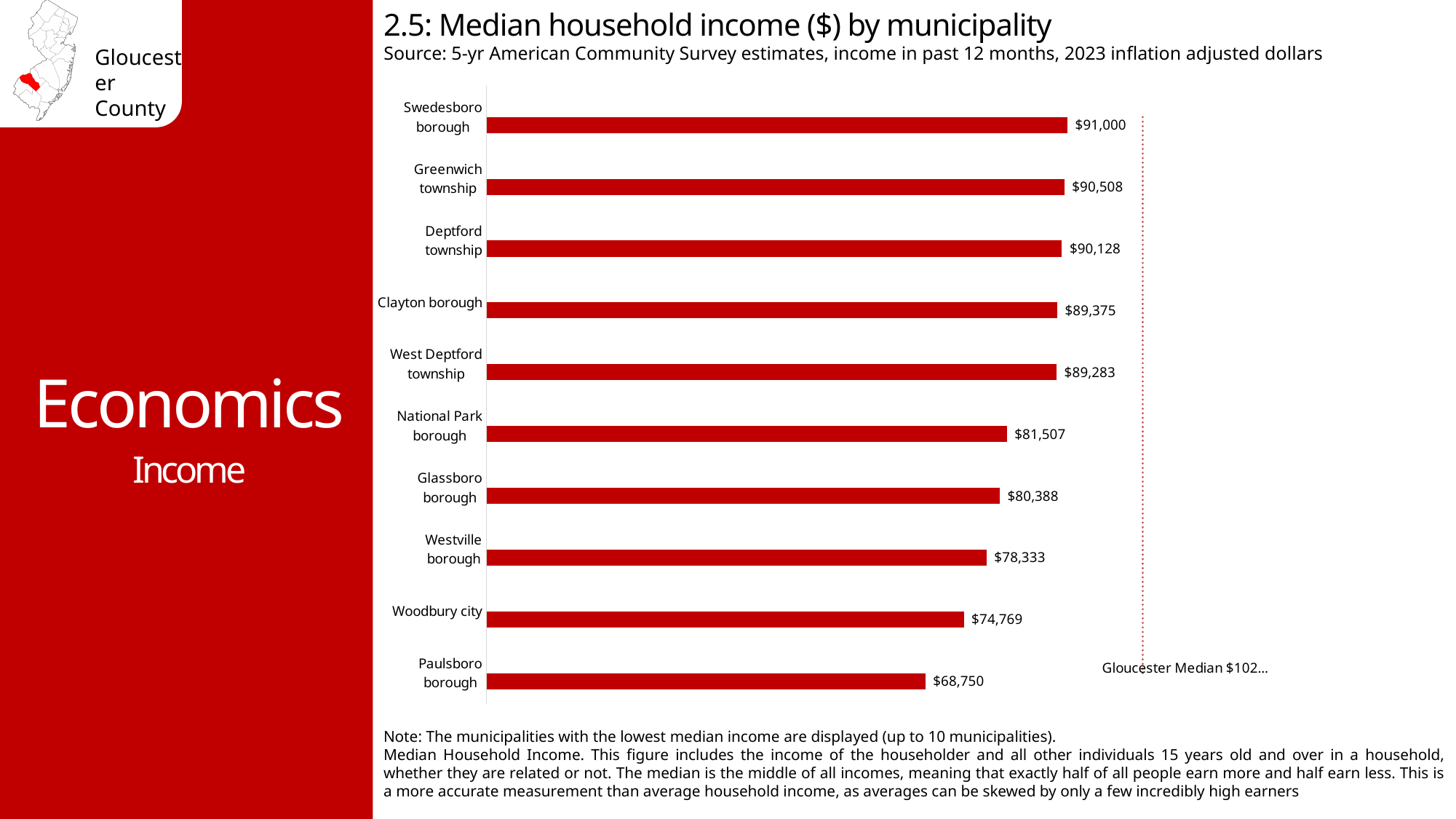
Which has a higher median household income, Westville borough or Woodbury city? Westville borough Which municipality has the lowest median household income shown on the chart? Paulsboro borough What is the median household income for Paulsboro borough? $68,750 What is the median household income for Woodbury city? $74,769 How many municipalities are shown on the chart? 10 What is the difference in median household income between Swedesboro borough and Paulsboro borough? $22,250 What is the median household income for Glassboro borough? $80,388 What is the difference in median household income between National Park borough and Glassboro borough? $1,119 What is the median household income for Swedesboro borough? $91,000 What is the title of the chart? 2.5: Median household income ($) by municipality Which municipality has the highest median household income shown on the chart? Swedesboro borough What kind of chart is used to show median household income by municipality? Bar chart